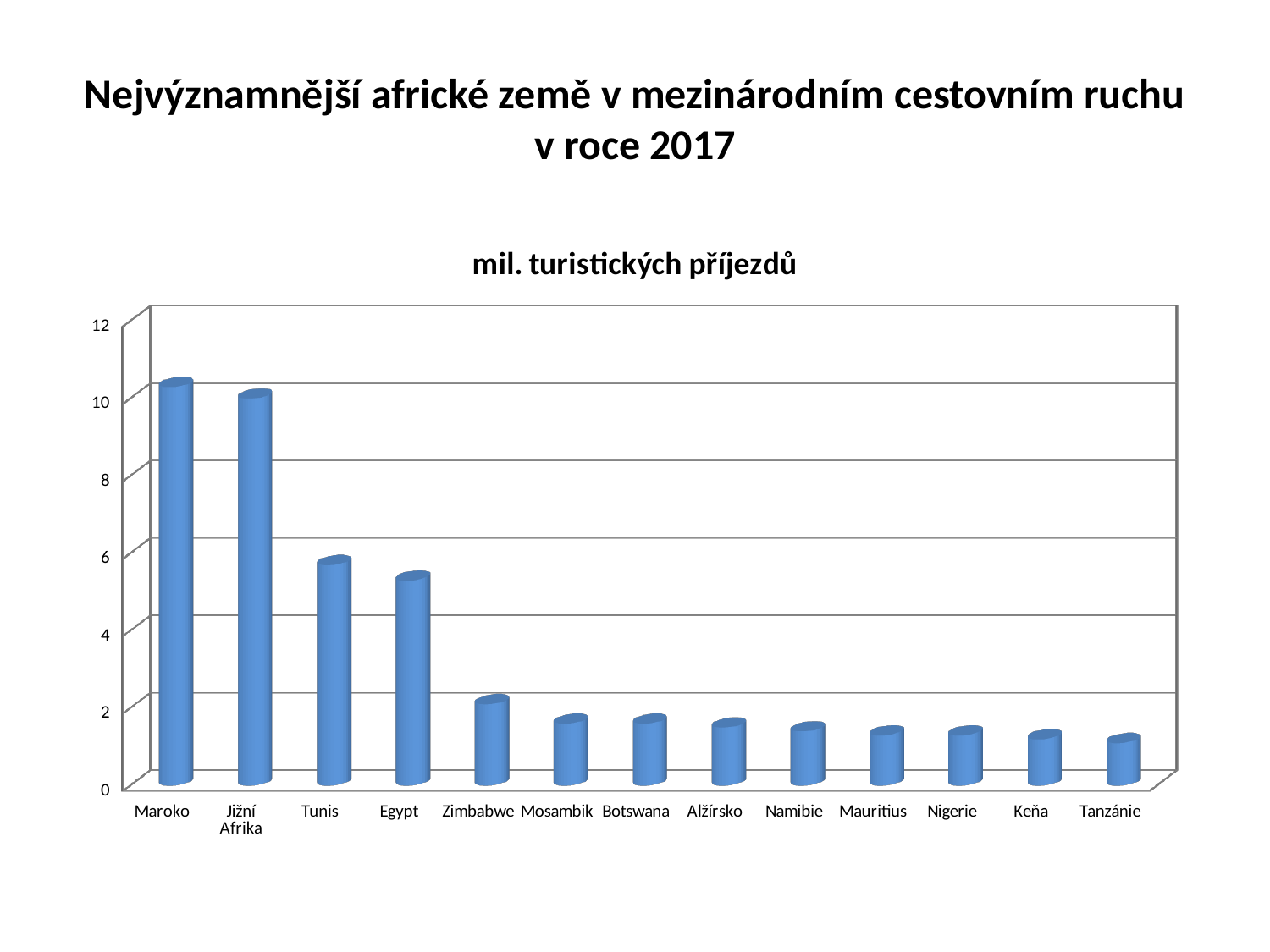
Which has the larger value, Tunis or Egypt? Tunis Is the value for Zimbabwe greater or less than 4? less What kind of chart is shown on the slide? bar chart Do the values rise or fall from left to right along the x axis? fall Is the value for Tunis greater or less than 6? less How many countries are shown on the x axis of the chart? 13 Is the value for Mosambik greater or less than 2? less What is the title of the chart? mil. turistických příjezdů Which country has the highest value in the chart? Maroko